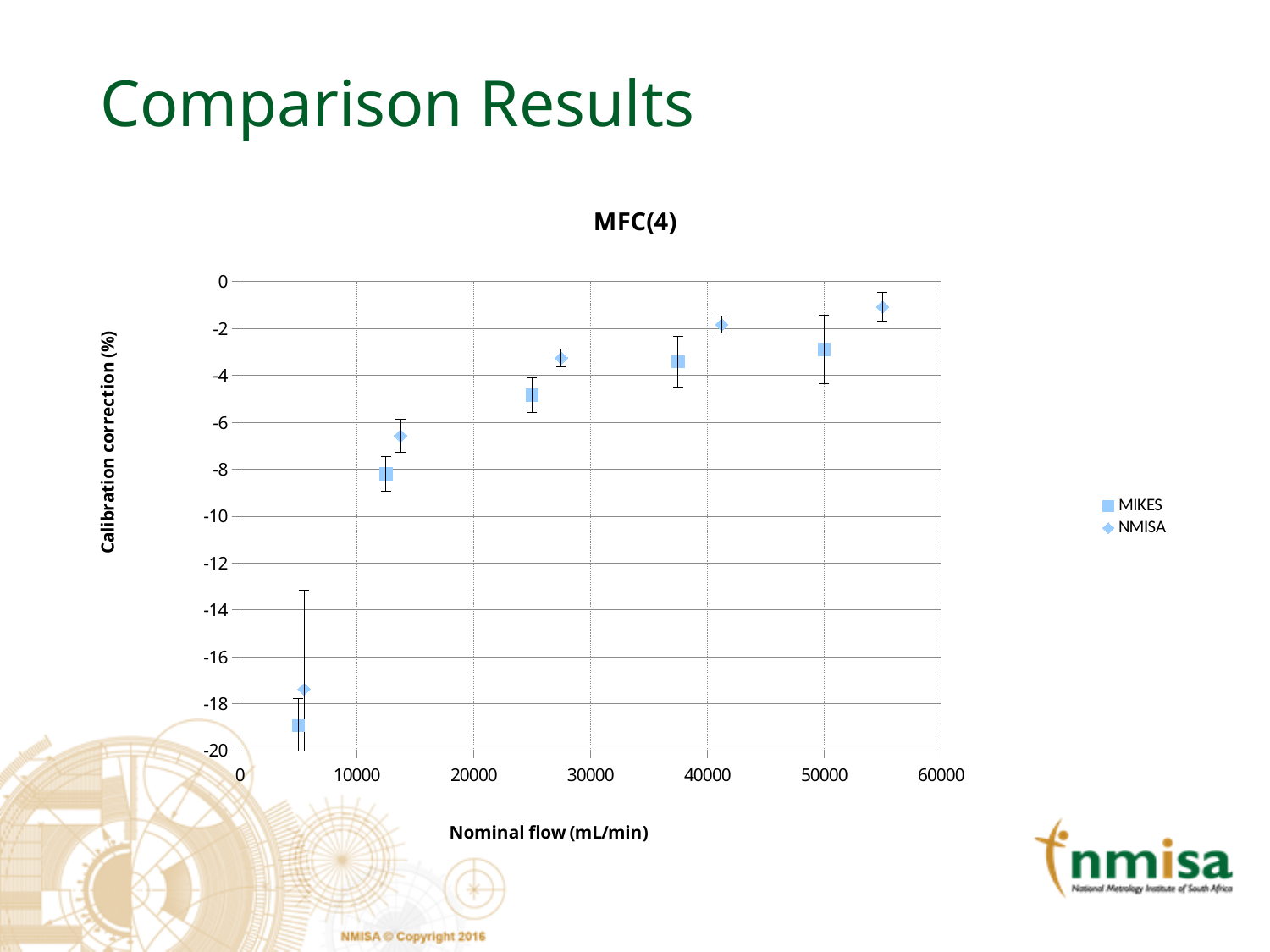
At the lowest nominal flow, which series has the higher calibration correction, MIKES or NMISA? NMISA Is the NMISA calibration correction at the highest nominal flow (around 55000 mL/min) greater or less than -2? greater How many data points are plotted for the NMISA series? 5 What is the title of the chart? MFC(4) Do the calibration correction values rise or fall as nominal flow increases? Rise Is the NMISA calibration correction at the lowest nominal flow (around 5000 mL/min) greater or less than -18? greater How many series does the legend list? 2 What kind of chart is shown on the slide? Scatter chart Is the MIKES calibration correction at the lowest nominal flow (around 5000 mL/min) greater or less than -18? less Which two series are listed in the legend? MIKES and NMISA How many data points are plotted for the MIKES series? 5